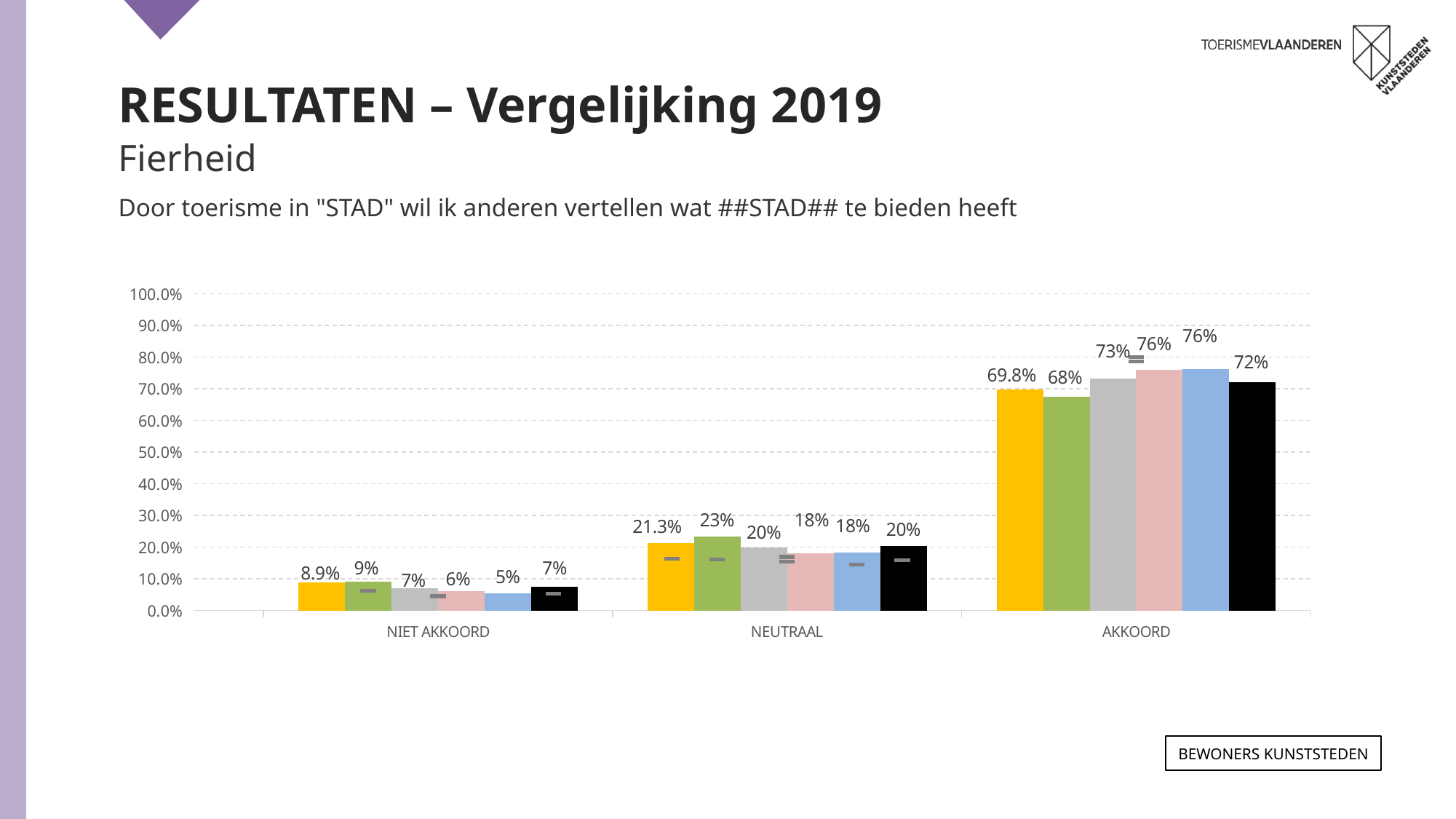
In the NEUTRAAL group, which is larger: the yellow bar or the green bar? The green bar What is the value of the yellow bar for NIET AKKOORD? 8.9% What is the difference between the yellow bar for AKKOORD and the yellow bar for NIET AKKOORD? 60.9 percentage points What is the value of the black bar for AKKOORD? 72% Which bar is the lowest in the NIET AKKOORD group? The blue bar (5%) Which bar is the lowest in the AKKOORD group? The green bar (68%) What kind of chart is shown on the slide? Bar chart What is the difference between the black bar for AKKOORD and the black bar for NEUTRAAL? 52 percentage points What is the value of the grey bar for AKKOORD? 73% What is the value of the green bar for NEUTRAAL? 23% How many categories are shown on the x axis? 3 How many bars are shown in each category group? 6